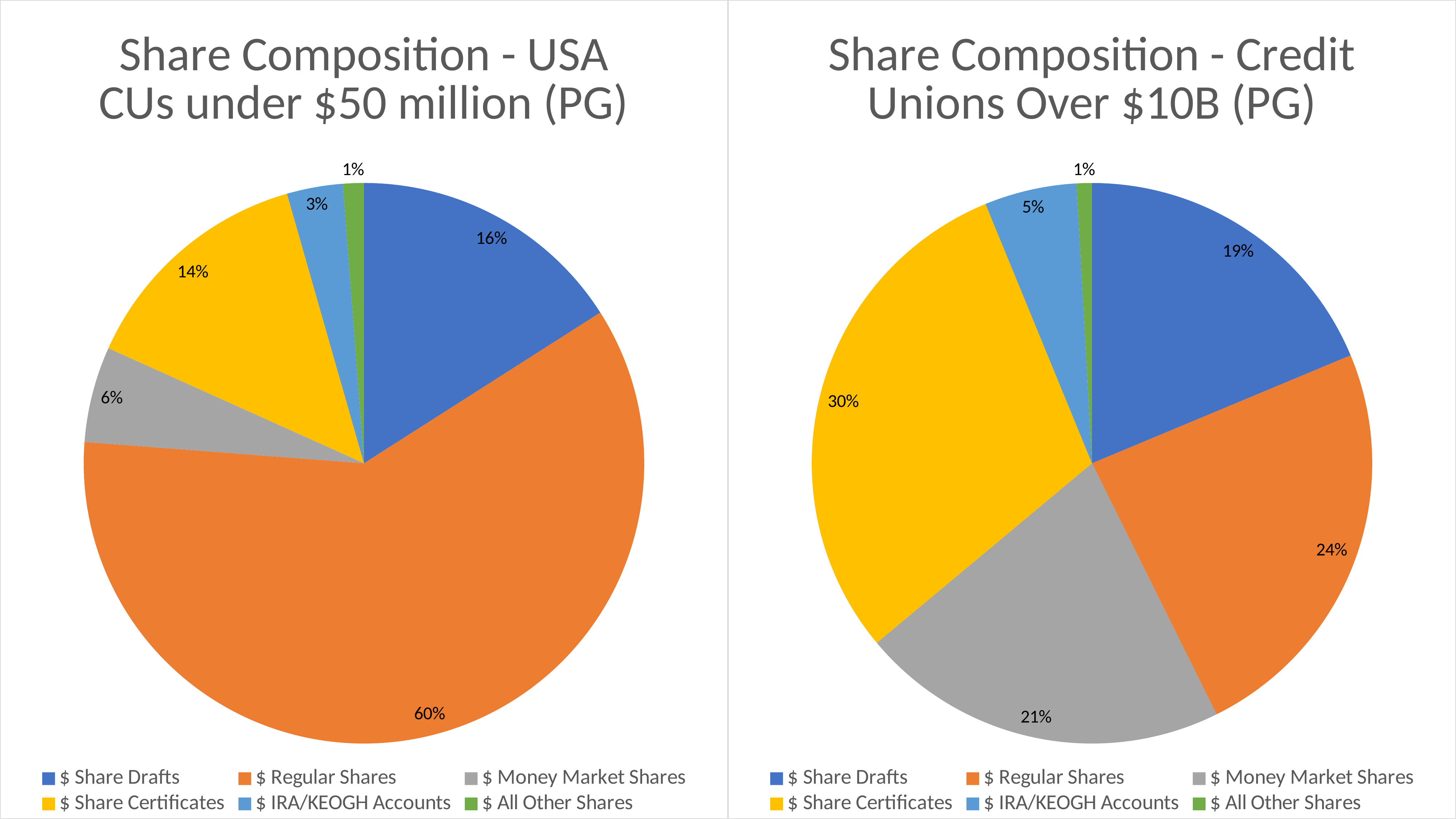
In the 'Share Composition - Credit Unions Over $10B (PG)' chart, which is larger: $ Regular Shares or $ Share Drafts? $ Regular Shares In the 'Share Composition - Credit Unions Over $10B (PG)' chart, which category has the largest share? $ Share Certificates In the 'Share Composition - Credit Unions Over $10B (PG)' chart, what share do $ Money Market Shares have? 21% In the 'Share Composition - USA CUs under $50 million (PG)' chart, what is the difference between the $ Share Certificates share and the $ Money Market Shares share? 8% What kind of chart is the 'Share Composition - Credit Unions Over $10B (PG)' chart? Pie chart In the 'Share Composition - USA CUs under $50 million (PG)' chart, which category has the smallest share? $ All Other Shares In the 'Share Composition - USA CUs under $50 million (PG)' chart, what share do $ Regular Shares have? 60% How many categories does the legend of the 'Share Composition - USA CUs under $50 million (PG)' chart list? 6 In the 'Share Composition - Credit Unions Over $10B (PG)' chart, what share do $ IRA/KEOGH Accounts have? 5% In the 'Share Composition - USA CUs under $50 million (PG)' chart, what share do $ Share Drafts have? 16% In the 'Share Composition - USA CUs under $50 million (PG)' chart, which colour represents $ Regular Shares? Orange In the 'Share Composition - Credit Unions Over $10B (PG)' chart, what share do $ Share Certificates have? 30%